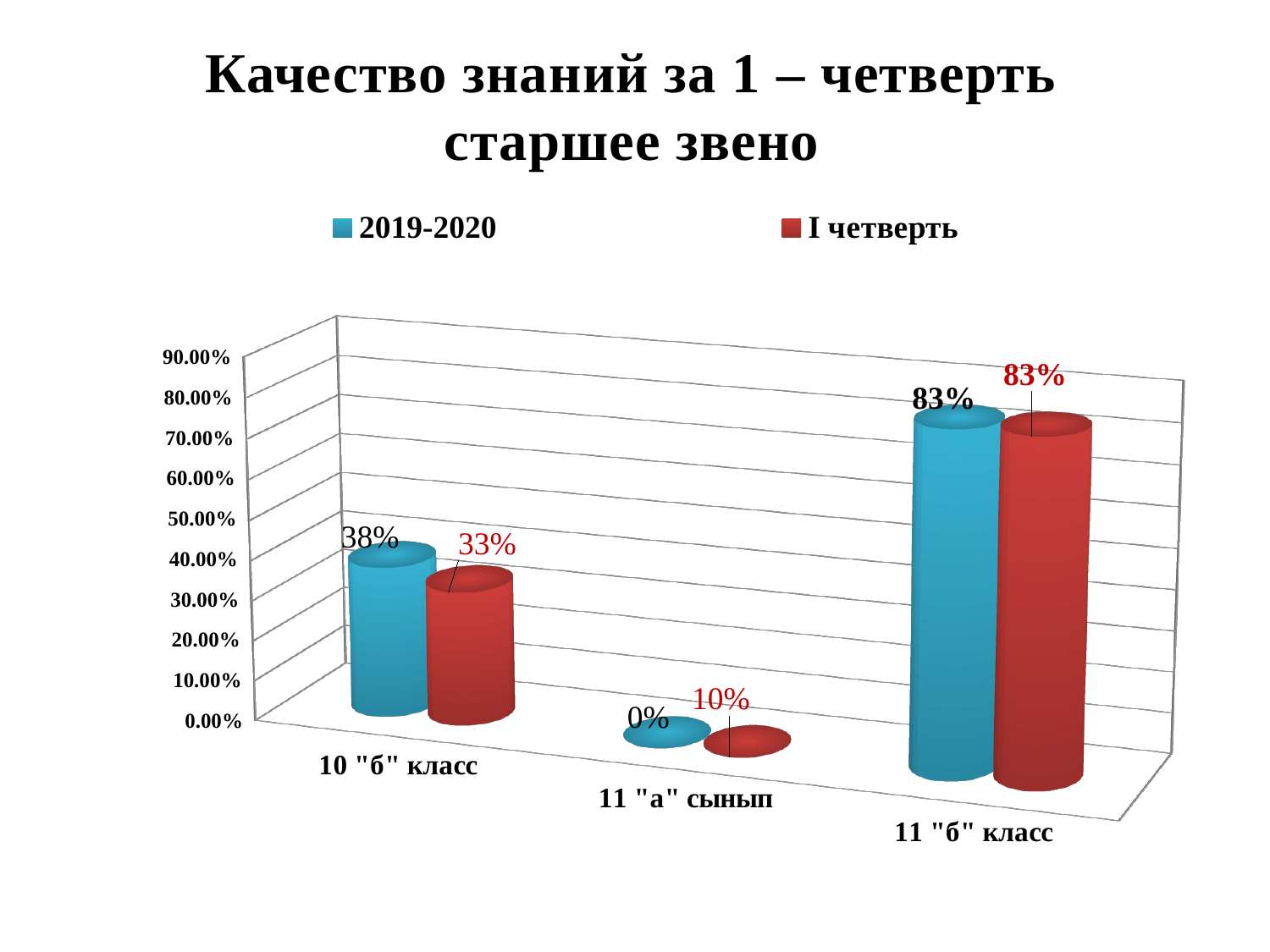
What is the value for 11 "а" сынып in the 2019-2020 series? 0% What is the value for 10 "б" класс in the I четверть series? 33% Which category has the highest value in the 2019-2020 series? 11 "б" класс How many categories are shown on the x axis? 3 What is the value for 11 "а" сынып in the I четверть series? 10% Which category has the lowest value in the I четверть series? 11 "а" сынып What is the difference between the 2019-2020 and I четверть values for 10 "б" класс? 5% What kind of chart is shown on the slide? Bar chart What is the value for 10 "б" класс in the 2019-2020 series? 38% How many series does the legend list? 2 What is the value for 11 "б" класс in the I четверть series? 83% Which is larger for 11 "а" сынып: the 2019-2020 value or the I четверть value? I четверть